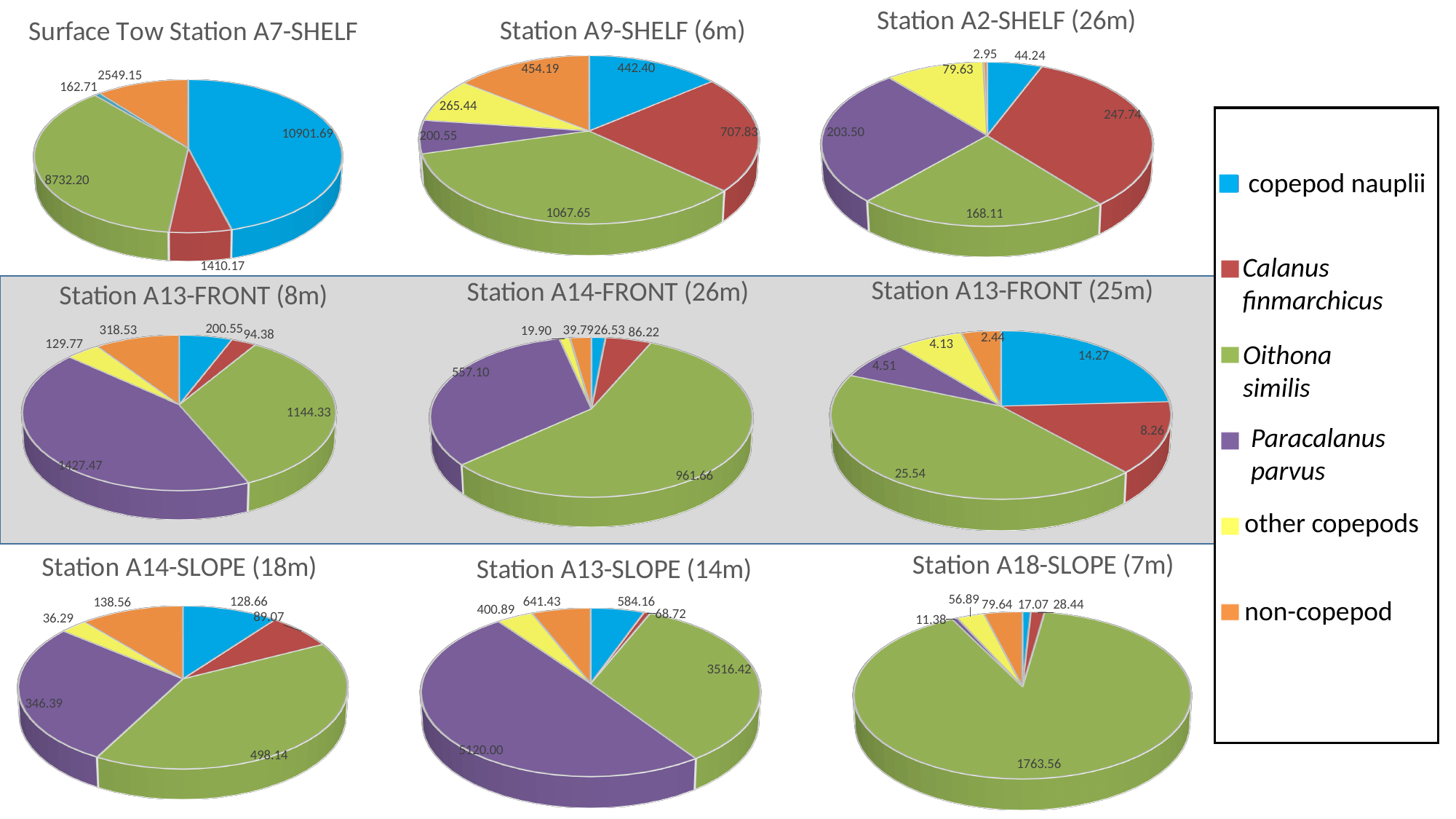
How many categories does the legend list? 6 What type of chart is used for Station A9-SHELF (6m)? pie chart In the Surface Tow Station A7-SHELF chart, what is the value for copepod nauplii? 10901.69 In the Station A18-SLOPE (7m) chart, what is the value for non-copepod? 79.64 In the Station A13-FRONT (25m) chart, which is larger: copepod nauplii or Calanus finmarchicus? copepod nauplii In the Station A14-SLOPE (18m) chart, what is the value for Paracalanus parvus? 346.39 In the Station A13-SLOPE (14m) chart, which category has the largest slice? Paracalanus parvus How many pie charts are shown on the slide? 9 In the Station A14-FRONT (26m) chart, what is the difference between the Oithona similis value and the Paracalanus parvus value? 404.56 In the Station A2-SHELF (26m) chart, which category has the largest slice? Calanus finmarchicus In the Station A13-FRONT (8m) chart, which category has the smallest slice? Calanus finmarchicus In the Station A9-SHELF (6m) chart, what is the value for Calanus finmarchicus? 707.83